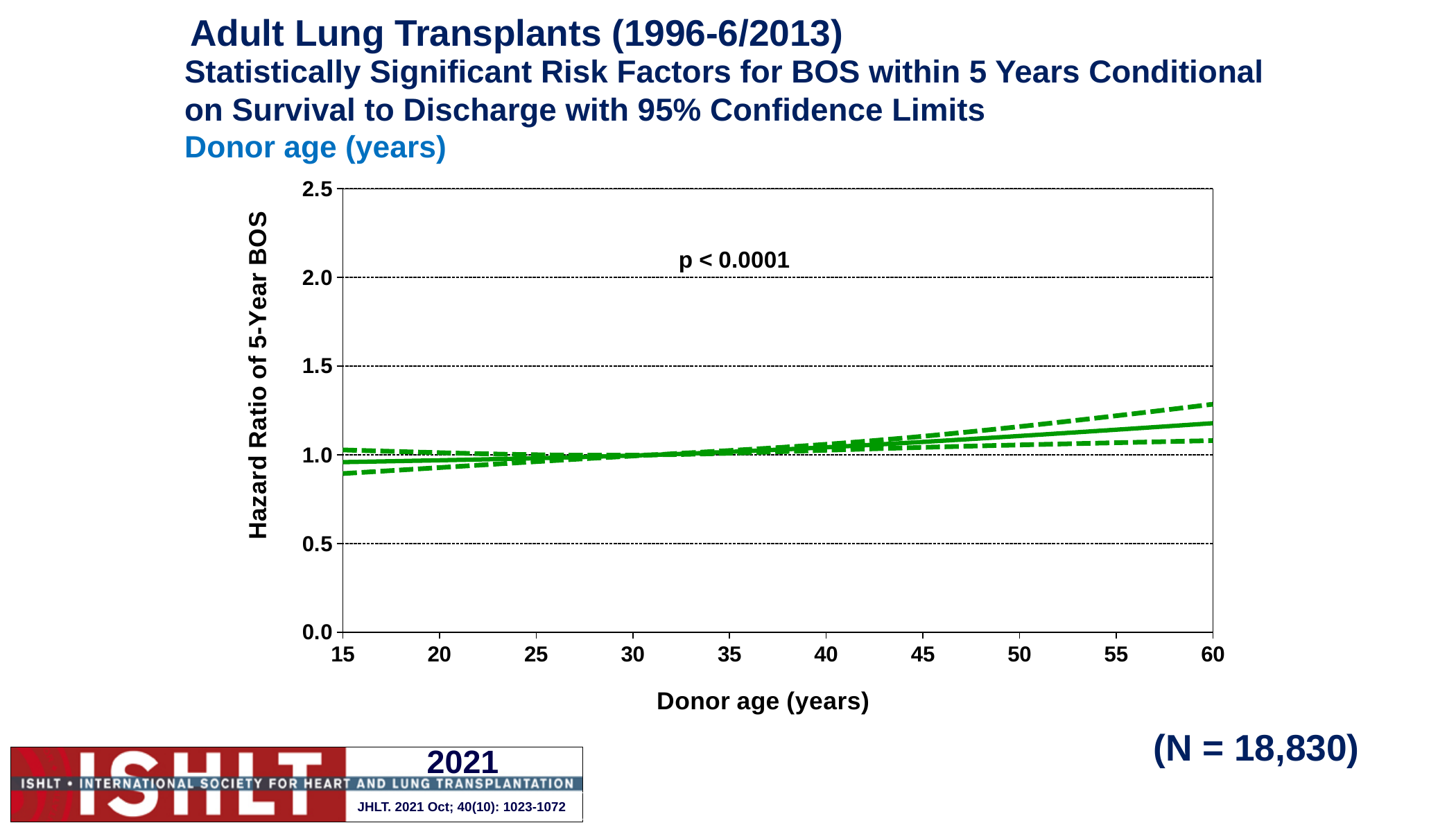
What p-value is printed on the chart? p < 0.0001 What kind of chart is shown on the slide? line chart What is the highest value shown on the y-axis? 2.5 Is the upper 95% confidence limit at a donor age of 60 years greater or less than 1.5? less Does the hazard ratio of 5-year BOS rise or fall as donor age increases from 15 to 60 years? rise How many lines are plotted on the chart (including the confidence limits)? 3 What is the label of the y-axis? Hazard Ratio of 5-Year BOS Is the hazard ratio for a donor age of 45 years greater or less than 2.0? less What is the range of donor age shown on the x-axis? 15 to 60 years Is the lower 95% confidence limit at a donor age of 15 years greater or less than 1.0? less